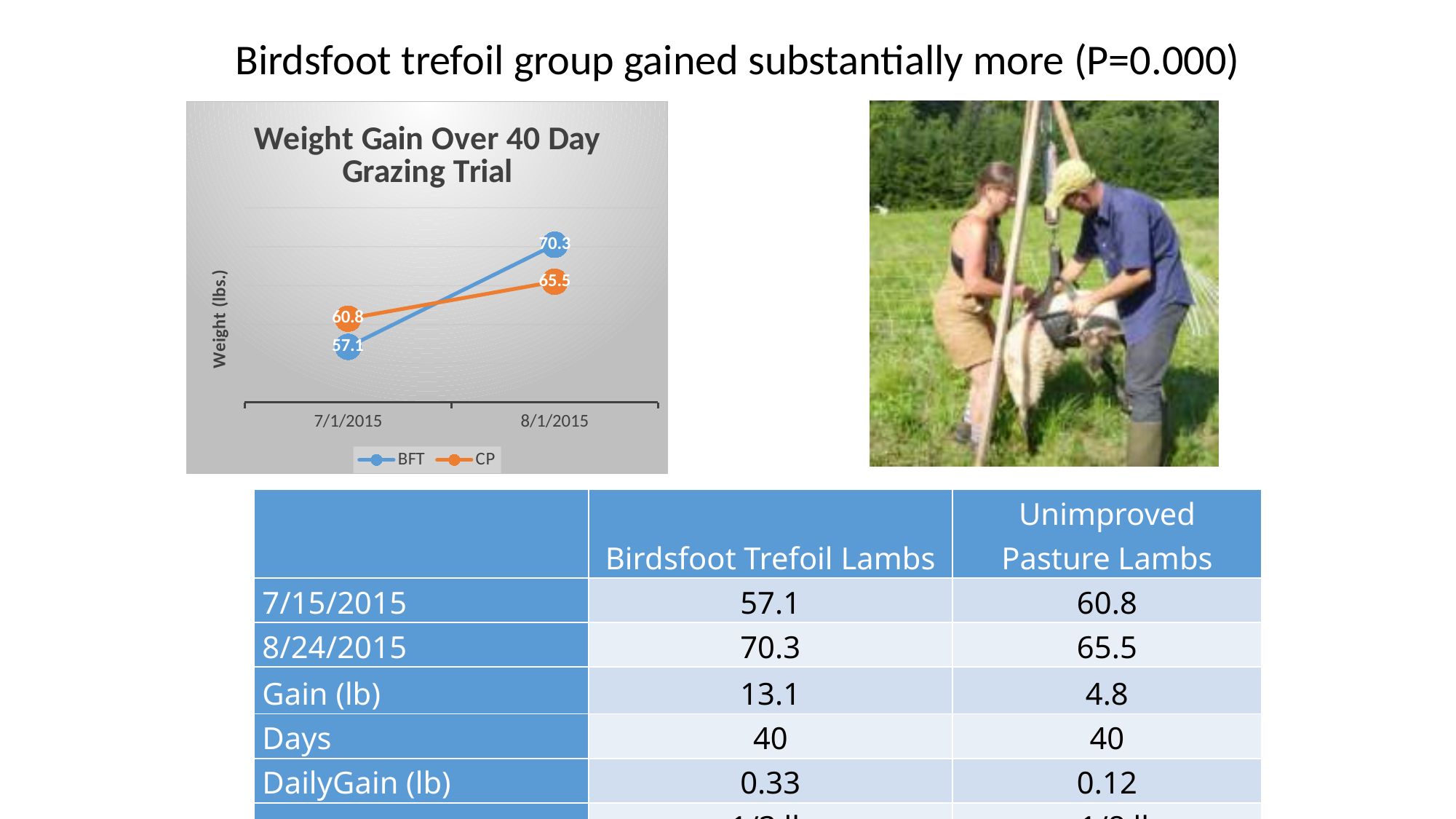
What is the title of the chart? Weight Gain Over 40 Day Grazing Trial Which series has the higher value on 8/1/2015, BFT or CP? BFT Does the BFT series rise or fall from 7/1/2015 to 8/1/2015? rise What is the difference between the BFT values on 8/1/2015 and 7/1/2015? 13.2 How many dates are shown on the x axis of the chart? 2 What is the value for BFT on 7/1/2015? 57.1 Which series has the higher value on 7/1/2015, BFT or CP? CP How many series does the chart legend list? 2 What is the value for BFT on 8/1/2015? 70.3 What type of chart is shown on the slide? line chart What is the value for CP on 7/1/2015? 60.8 What is the value for CP on 8/1/2015? 65.5